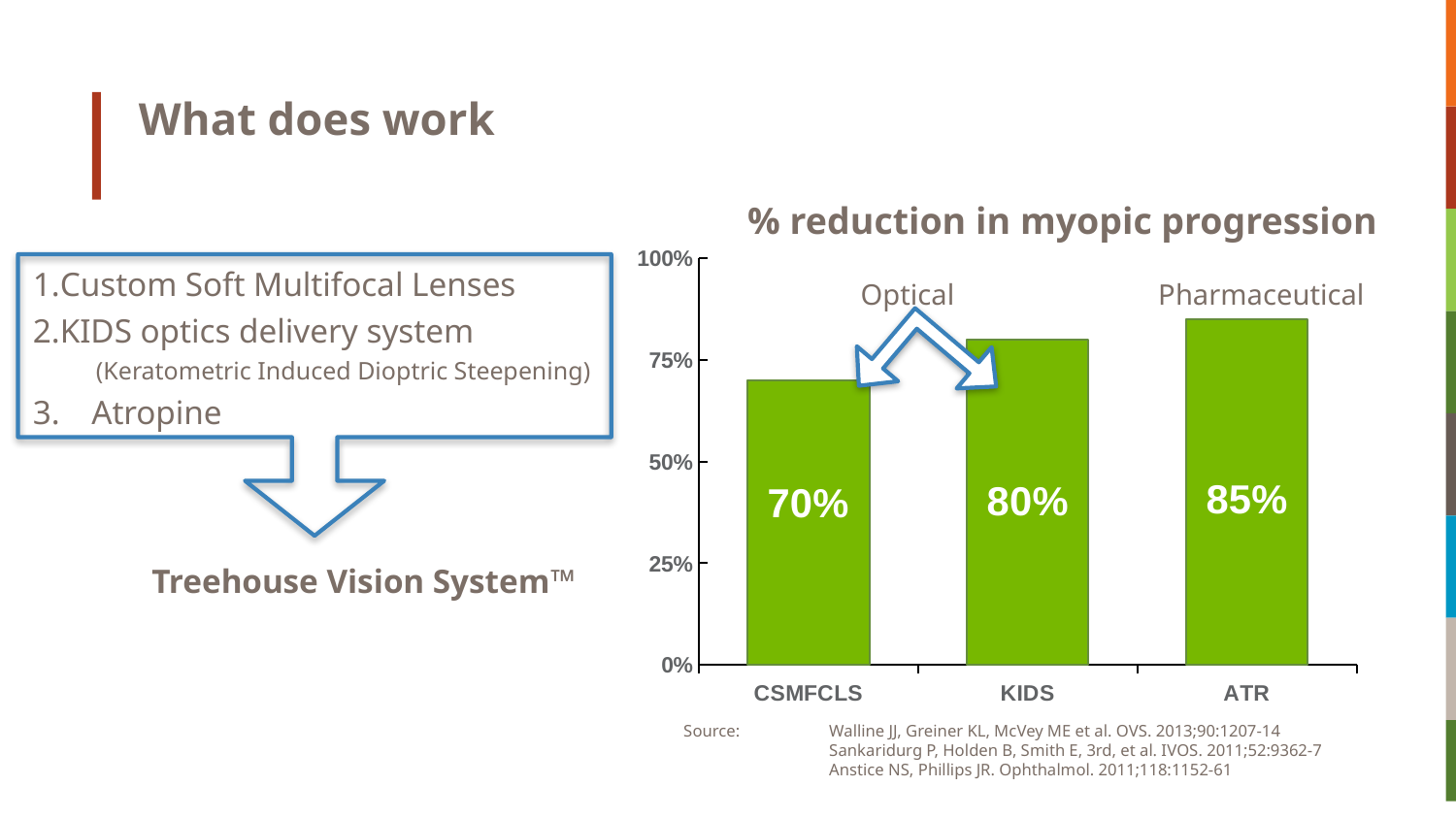
Which category has the highest % reduction in myopic progression? ATR How many categories are shown in the chart? 3 What is the difference between the values for ATR and CSMFCLS? 15% What is the difference between the values for KIDS and CSMFCLS? 10% Which category has the lowest % reduction in myopic progression? CSMFCLS Is the value for CSMFCLS greater or less than 75%? less What is the value for ATR? 85% What is the value for CSMFCLS? 70% What kind of chart is shown on the slide? bar chart What is the value for KIDS? 80% What is the title of the chart? % reduction in myopic progression Which is larger, the value for KIDS or the value for ATR? ATR